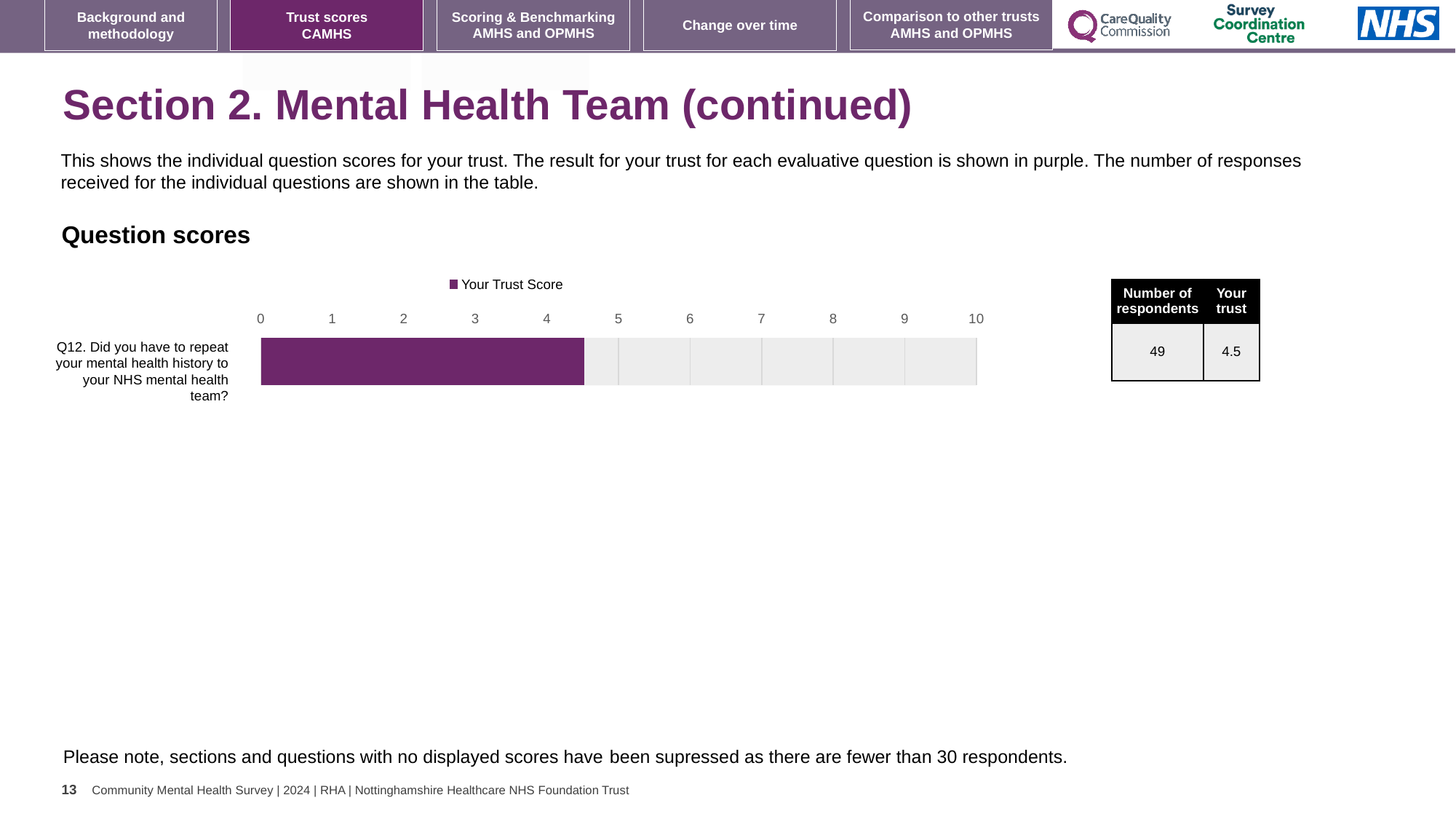
What is the trust score for Q12 (Did you have to repeat your mental health history to your NHS mental health team?)? 4.5 What is the series name shown in the legend of the Question scores chart? Your Trust Score What is the maximum value shown on the x axis of the Question scores chart? 10 Which question is plotted in the Question scores chart? Q12. Did you have to repeat your mental health history to your NHS mental health team? Is the trust score for Q12 greater or less than 5? less How many respondents answered Q12 according to the table next to the chart? 49 What type of chart is shown under 'Question scores'? bar chart How many series does the legend of the Question scores chart list? 1 How many questions (bars) are plotted in the Question scores chart? 1 Is the trust score for Q12 greater or less than 4? greater